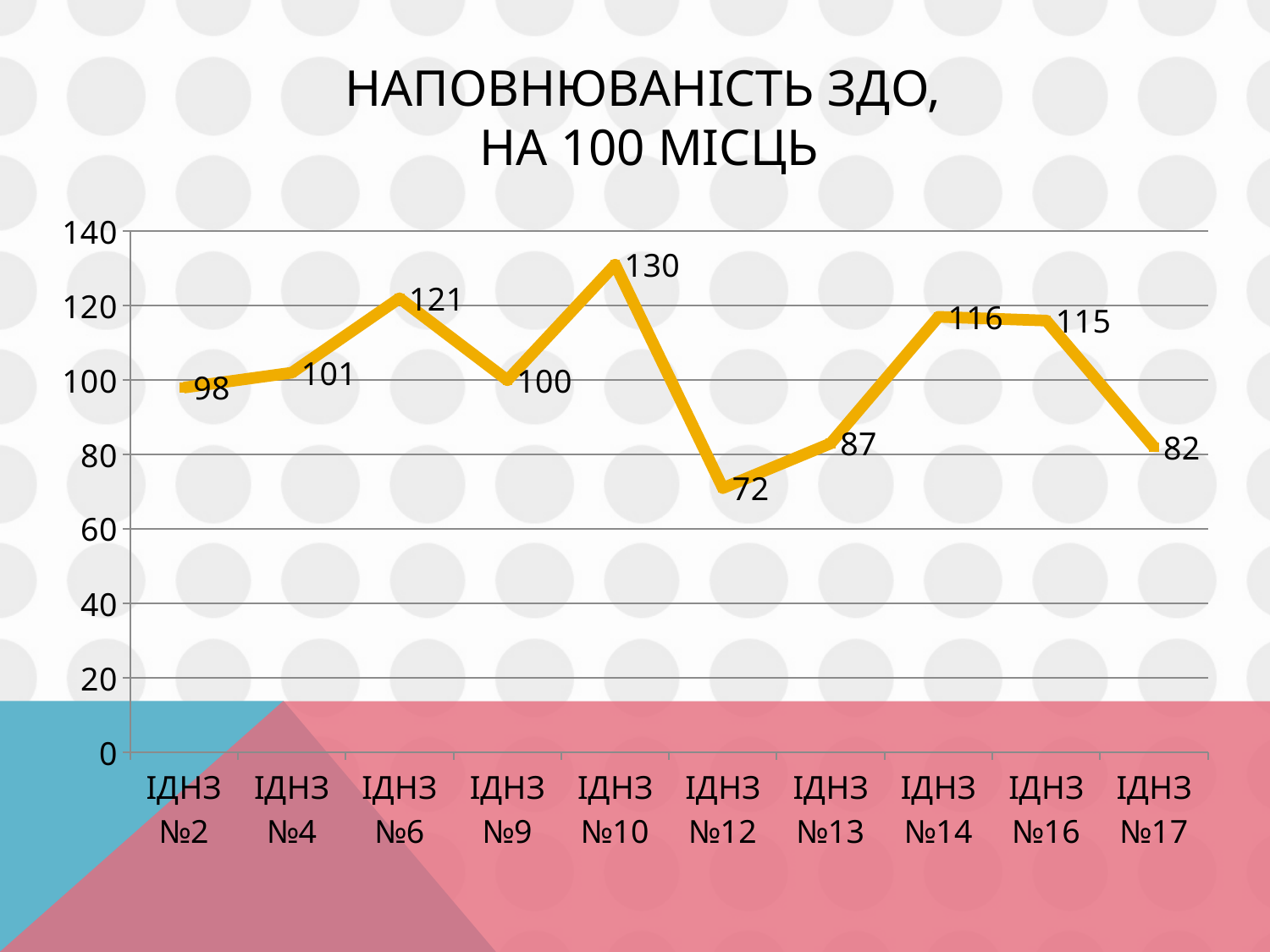
What is the difference between the values for ІДНЗ №10 and ІДНЗ №12? 58 Which category has the highest value? ІДНЗ №10 Do the values rise or fall from ІДНЗ №2 to ІДНЗ №6? rise What is the value for ІДНЗ №17? 82 What is the value for ІДНЗ №10? 130 Which category has the lowest value? ІДНЗ №12 What kind of chart is shown on the slide? line chart Which is larger, the value for ІДНЗ №6 or the value for ІДНЗ №14? ІДНЗ №6 Is the value for ІДНЗ №13 greater or less than 100? less What is the title of the chart? НАПОВНЮВАНІСТЬ ЗДО, НА 100 МІСЦЬ How many categories are shown on the x axis? 10 What is the value for ІДНЗ №12? 72